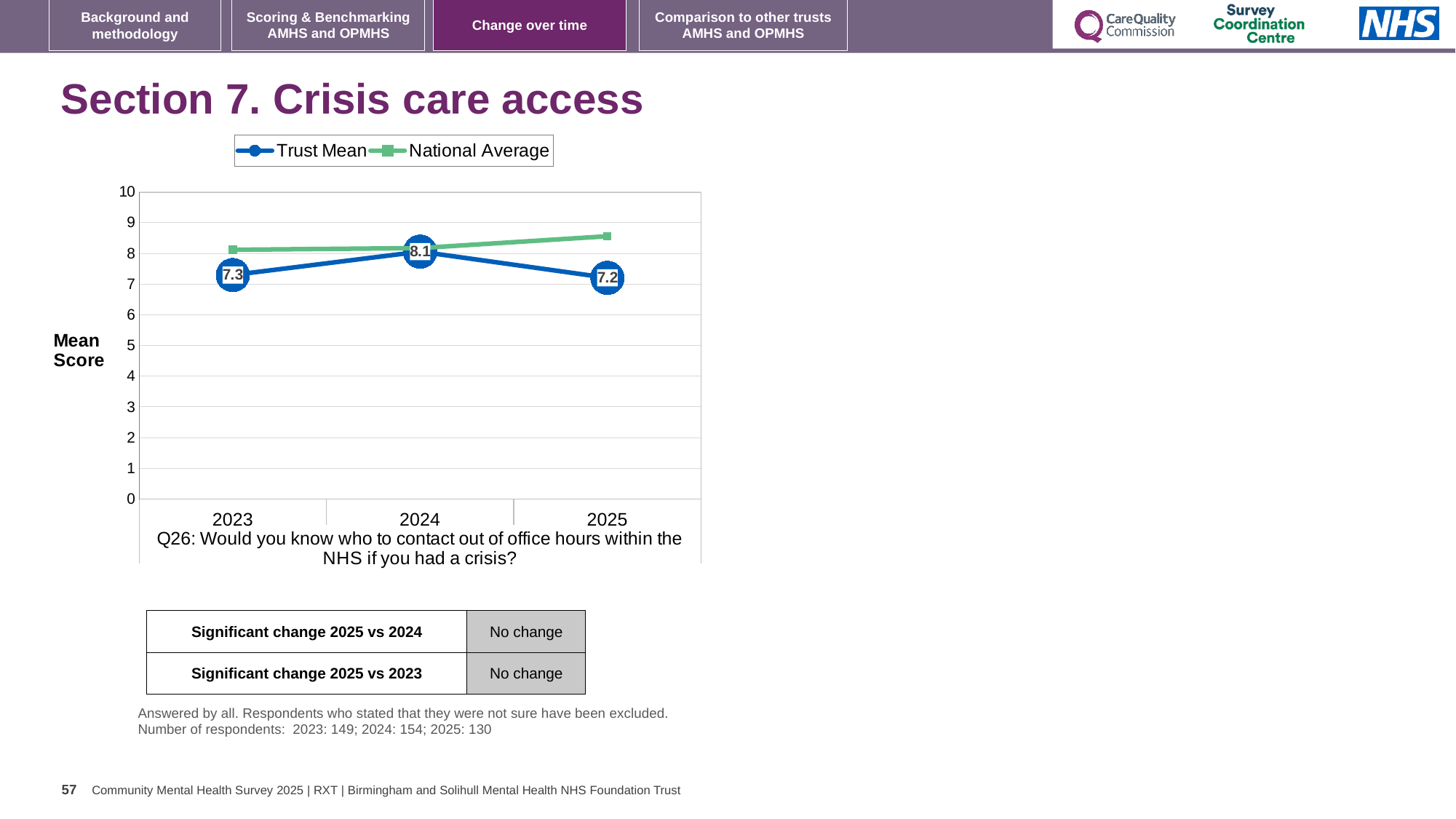
How many years are plotted on the x axis? 3 Is the National Average value for 2025 greater or less than 8? greater What is the Trust Mean score for 2023? 7.3 What is the Trust Mean score for 2025? 7.2 What kind of chart is shown on the slide? Line chart In which year is the Trust Mean highest? 2024 What is the Trust Mean score for 2024? 8.1 In which year is the Trust Mean lowest? 2025 In 2025, which is higher: the Trust Mean or the National Average? National Average What is the difference between the Trust Mean in 2024 and in 2023? 0.8 How many series does the legend list? 2 Does the Trust Mean rise or fall from 2024 to 2025? Fall